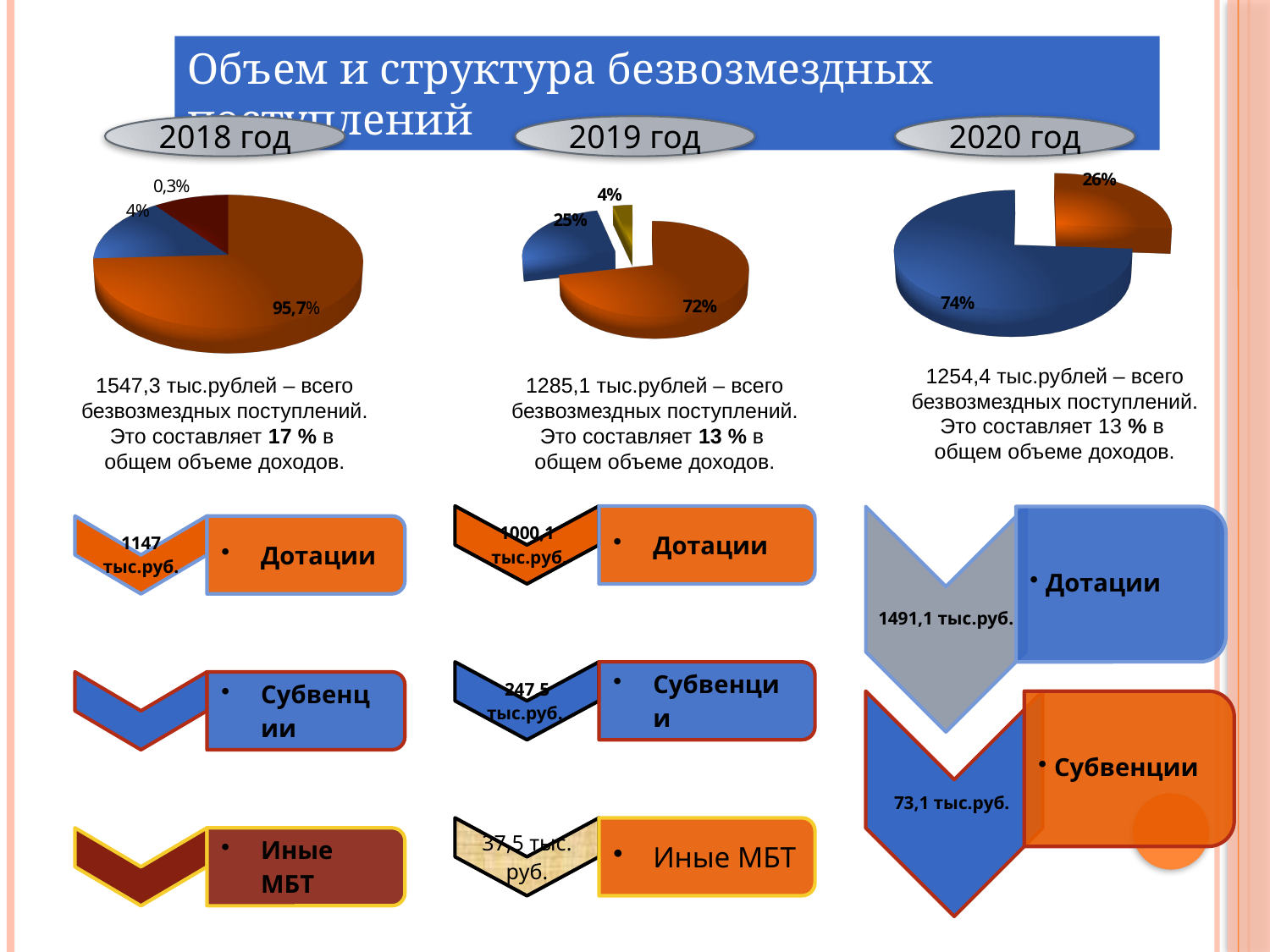
In the 2019 год pie chart, what is the share of the largest slice? 72% In the 2018 год pie chart, what is the share of the largest slice? 95,7% In the 2018 год pie chart, what is the share of the smallest slice? 0,3% In the 2019 год pie chart, what is the share of the smallest slice? 4% How many slices does the 2018 год pie chart have? 3 Which year's pie chart has the larger biggest slice, 2018 год or 2019 год? 2018 год How many slices does the 2020 год pie chart have? 2 In the 2020 год pie chart, what is the share of the smaller slice? 26% In the 2020 год pie chart, what is the share of the largest slice? 74% How many slices does the 2019 год pie chart have? 3 What kind of chart is used for each of the three years on the slide? Pie chart In the 2019 год pie chart, by how many percentage points does the 72% slice exceed the 25% slice? 47 percentage points